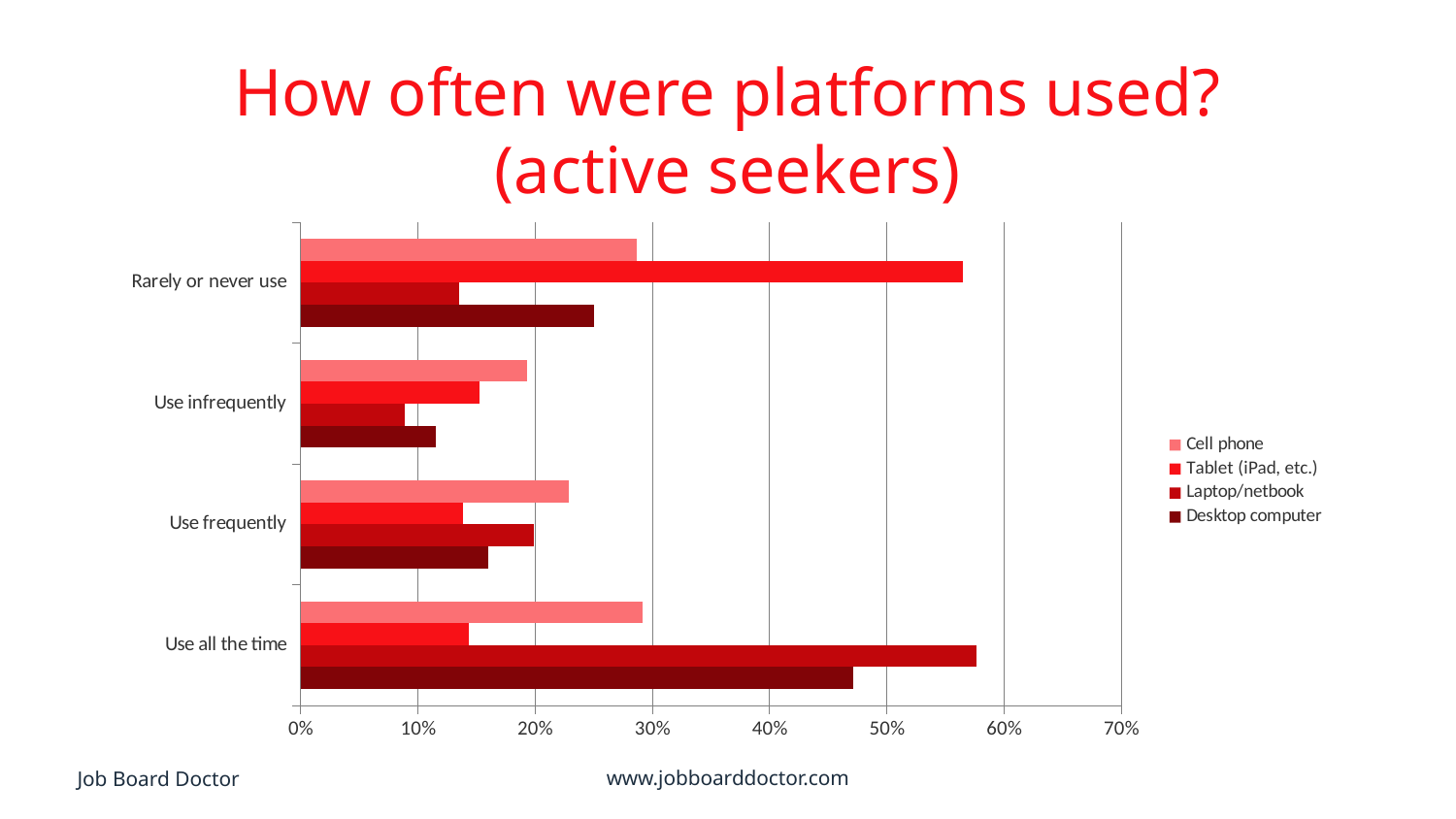
In the 'Use infrequently' category, which platform has the lowest value? Laptop/netbook How many series does the legend list? 4 What kind of chart is shown on the slide? bar chart Is the value for Cell phone in the 'Use all the time' category greater or less than 20%? greater How many usage-frequency categories are shown on the chart? 4 Is the value for Tablet (iPad, etc.) in the 'Rarely or never use' category greater or less than 50%? greater In the 'Use frequently' category, which is larger: the value for Cell phone or the value for Tablet (iPad, etc.)? Cell phone In the 'Use all the time' category, which platform has the highest value? Laptop/netbook What is the title of the chart? How often were platforms used? (active seekers) Is the value for Laptop/netbook in the 'Use all the time' category greater or less than 50%? greater In the 'Rarely or never use' category, which platform has the highest value? Tablet (iPad, etc.)